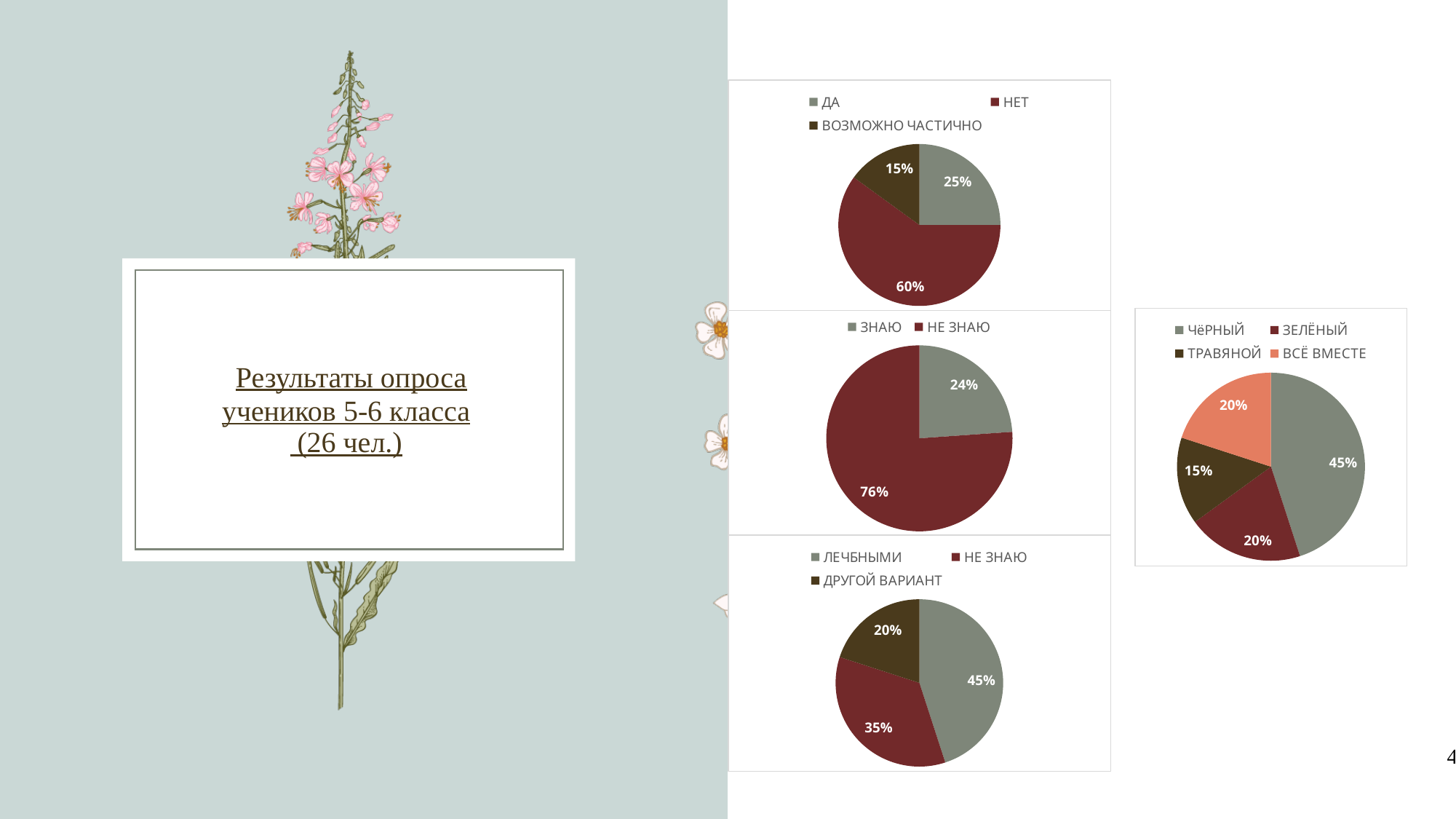
In the pie chart on the right of the slide (legend ЧёРНЫЙ, ЗЕЛЁНЫЙ, ТРАВЯНОЙ, ВСЁ ВМЕСТЕ), how many categories does the legend list? 4 In the top pie chart of the middle column (legend ДА, НЕТ, ВОЗМОЖНО ЧАСТИЧНО), which category has the largest slice? НЕТ In the top pie chart of the middle column (legend ДА, НЕТ, ВОЗМОЖНО ЧАСТИЧНО), what share does НЕТ have? 60% In the middle pie chart of the middle column (legend ЗНАЮ, НЕ ЗНАЮ), how many series does the legend list? 2 In the bottom pie chart of the middle column (legend ЛЕЧБНЫМИ, НЕ ЗНАЮ, ДРУГОЙ ВАРИАНТ), what share does ЛЕЧБНЫМИ have? 45% In the top pie chart of the middle column (legend ДА, НЕТ, ВОЗМОЖНО ЧАСТИЧНО), what share does ВОЗМОЖНО ЧАСТИЧНО have? 15% In the pie chart on the right of the slide (legend ЧёРНЫЙ, ЗЕЛЁНЫЙ, ТРАВЯНОЙ, ВСЁ ВМЕСТЕ), what share does ЧёРНЫЙ have? 45% In the bottom pie chart of the middle column (legend ЛЕЧБНЫМИ, НЕ ЗНАЮ, ДРУГОЙ ВАРИАНТ), which is larger: ЛЕЧБНЫМИ or НЕ ЗНАЮ? ЛЕЧБНЫМИ In the bottom pie chart of the middle column (legend ЛЕЧБНЫМИ, НЕ ЗНАЮ, ДРУГОЙ ВАРИАНТ), which category has the smallest slice? ДРУГОЙ ВАРИАНТ In the middle pie chart of the middle column (legend ЗНАЮ, НЕ ЗНАЮ), what share does НЕ ЗНАЮ have? 76% In the middle pie chart of the middle column (legend ЗНАЮ, НЕ ЗНАЮ), what is the difference between the НЕ ЗНАЮ and ЗНАЮ shares? 52% What kind of chart is the chart on the right of the slide (legend ЧёРНЫЙ, ЗЕЛЁНЫЙ, ТРАВЯНОЙ, ВСЁ ВМЕСТЕ)? Pie chart